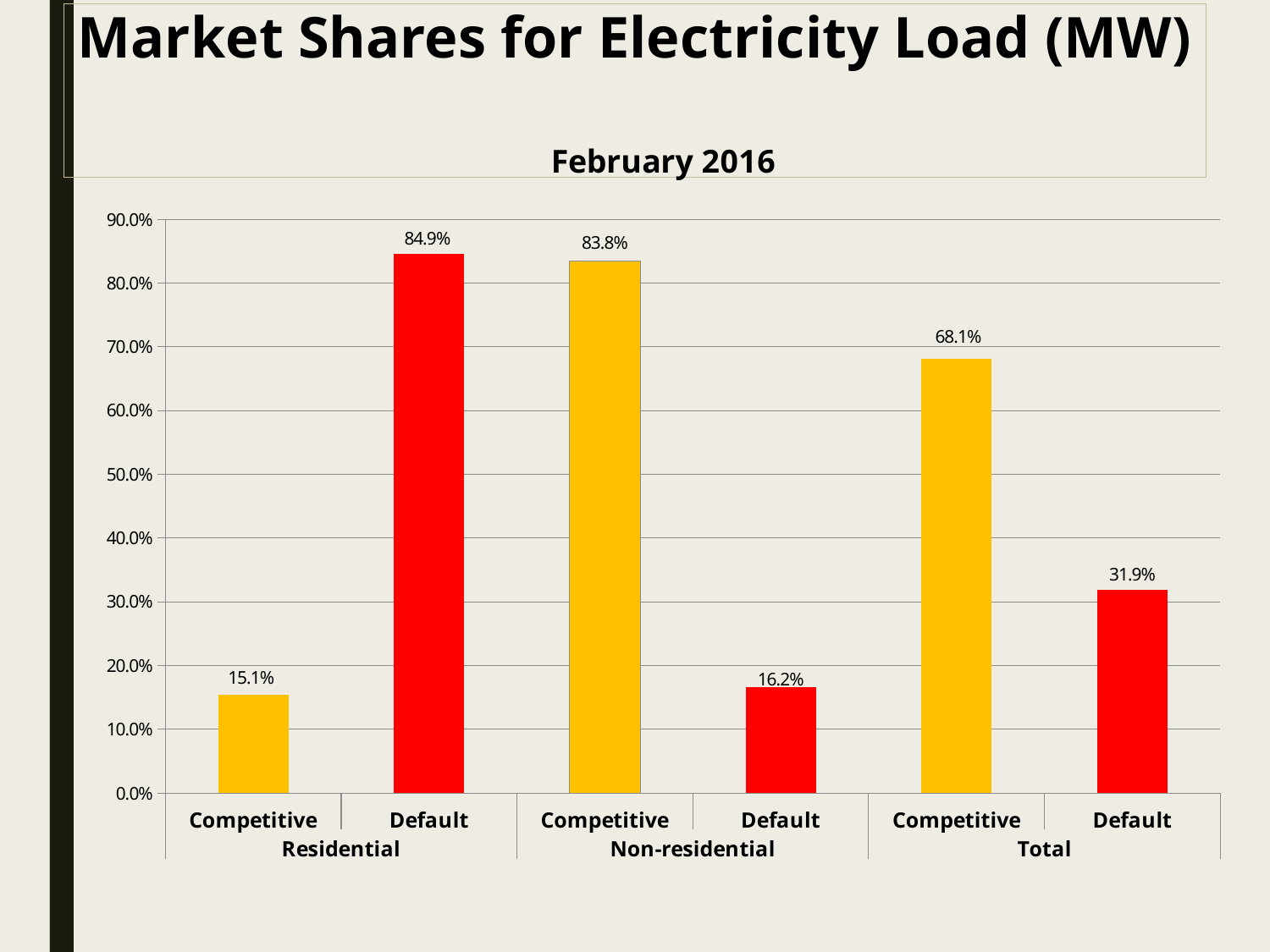
Is the value for Default in the Total group greater or less than 40.0%? less What kind of chart is shown on the slide? bar chart Which is larger: Competitive in Non-residential or Competitive in Total? Competitive in Non-residential Which bar has the highest value on the chart? Residential Default What is the value for Competitive in the Total group? 68.1% Which bar has the lowest value on the chart? Residential Competitive What is the value for Default in the Non-residential group? 16.2% What is the total of the Competitive and Default values in the Non-residential group? 100.0% What month and year does the chart subtitle refer to? February 2016 What is the value for Competitive in the Residential group? 15.1% How many bars are plotted on the chart? 6 What is the difference between the Default values for Residential and Total? 53.0%